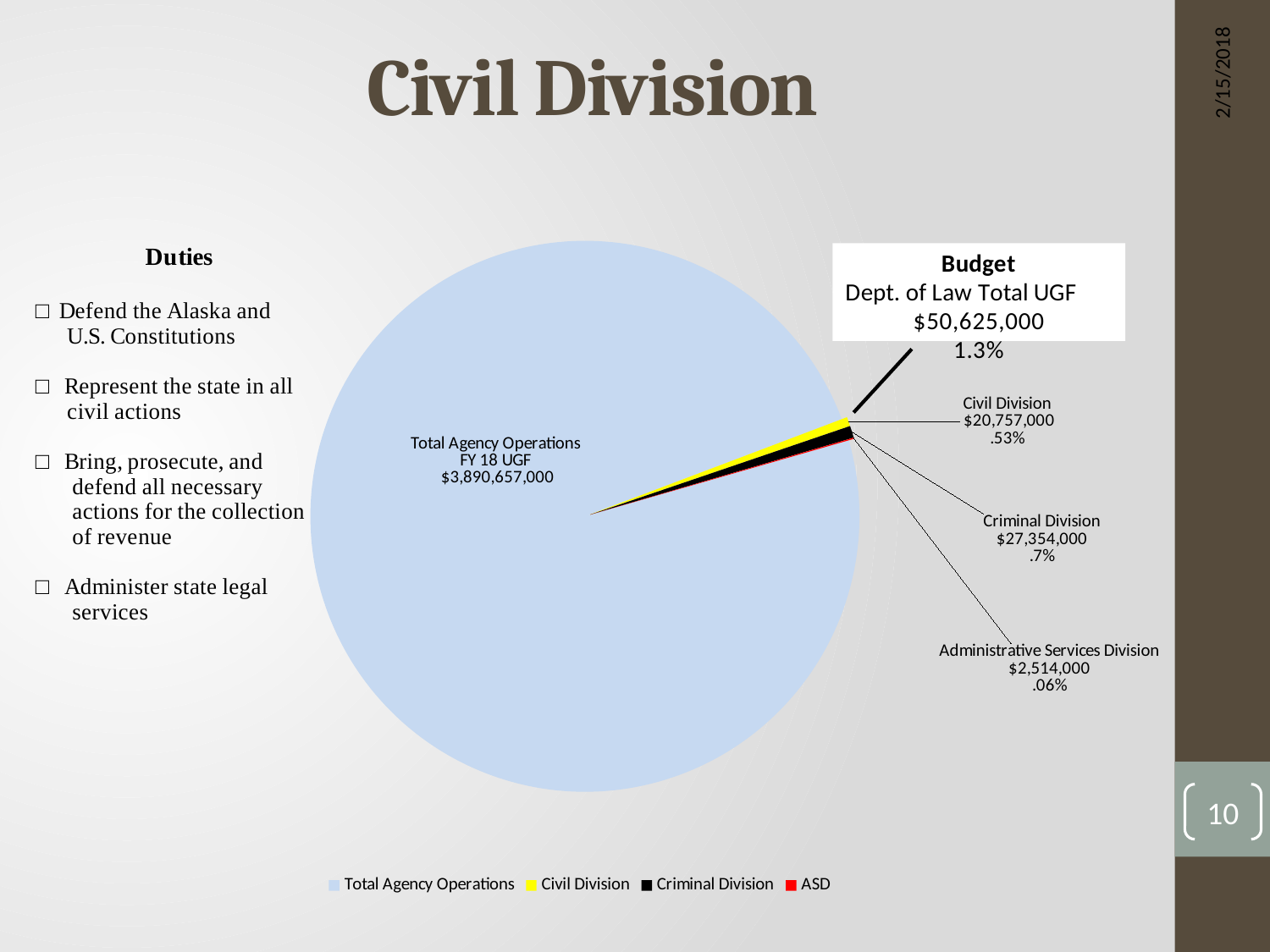
How many entries does the legend list? 4 Which slice of the pie is the largest? Total Agency Operations What kind of chart is shown on the slide? pie chart Which is larger, the Criminal Division value or the Civil Division value? Criminal Division What is the difference between the Criminal Division value and the Civil Division value? $6,597,000 What is the value shown for the Criminal Division slice? $27,354,000 What percentage share is labelled for the Criminal Division slice? .7% Which of the three Dept. of Law divisions has the smallest slice? Administrative Services Division What is the value shown for the Civil Division slice? $20,757,000 What is the value shown for the Administrative Services Division slice? $2,514,000 What percentage share is labelled for the Civil Division slice? .53% What is the value shown for Total Agency Operations FY 18 UGF? $3,890,657,000